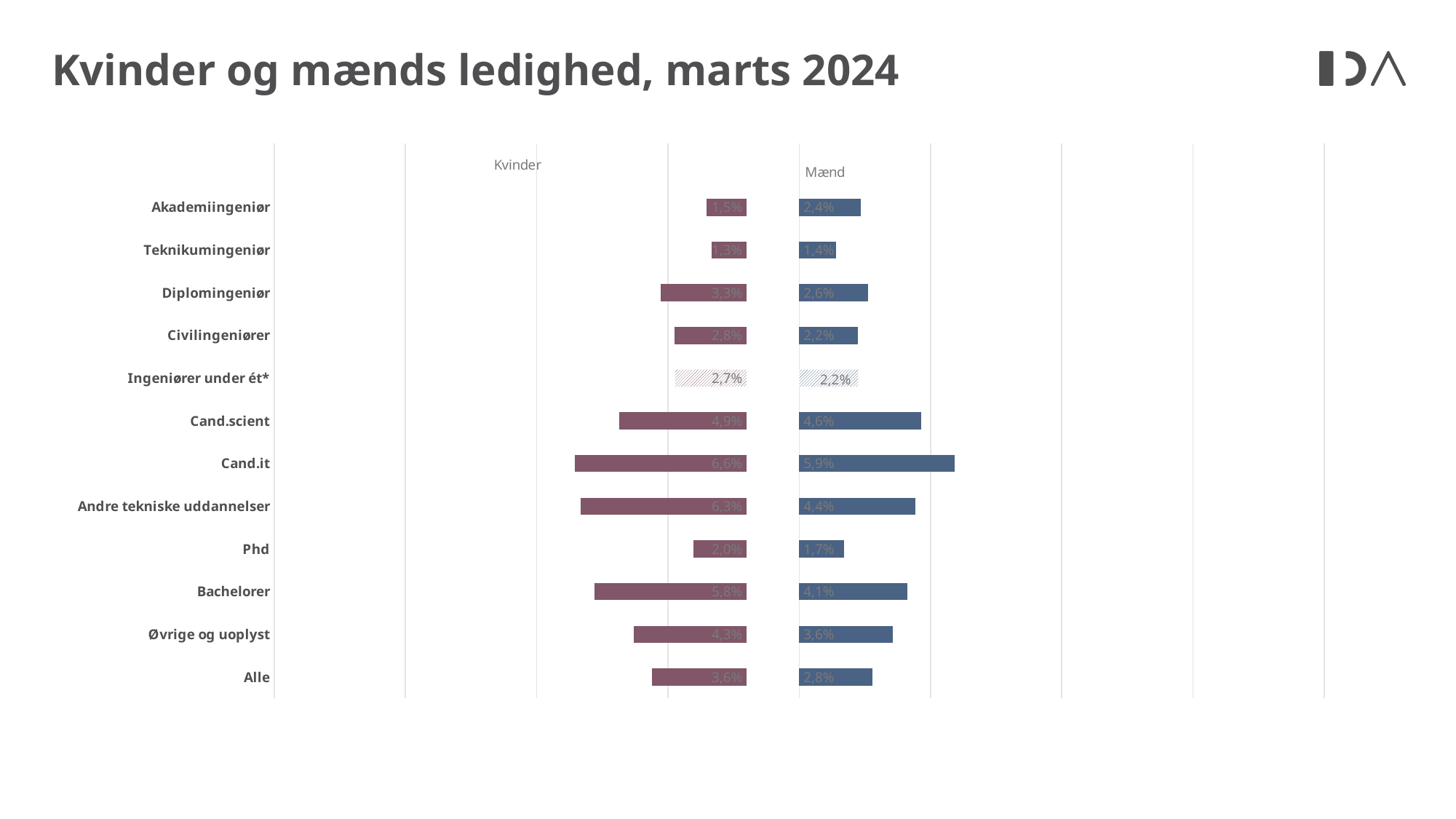
What is the unemployment rate for Mænd in the Bachelorer category? 4,1% What kind of chart is shown on the slide? Bar chart For Diplomingeniør, which is larger: the Kvinder value or the Mænd value? Kvinder What is the difference between the Kvinder and Mænd values for Andre tekniske uddannelser? 1,9 percentage points What is the value for Kvinder in the Alle category? 3,6% Which category has the lowest value for Mænd? Teknikumingeniør What is the unemployment rate for Kvinder in the Cand.it category? 6,6% What is the difference between the Kvinder and Mænd values for Alle? 0,8 percentage points Which category has the highest value for Kvinder? Cand.it For Akademiingeniør, which is larger: the Kvinder value or the Mænd value? Mænd How many series does the chart show? 2 How many categories are shown on the chart? 12